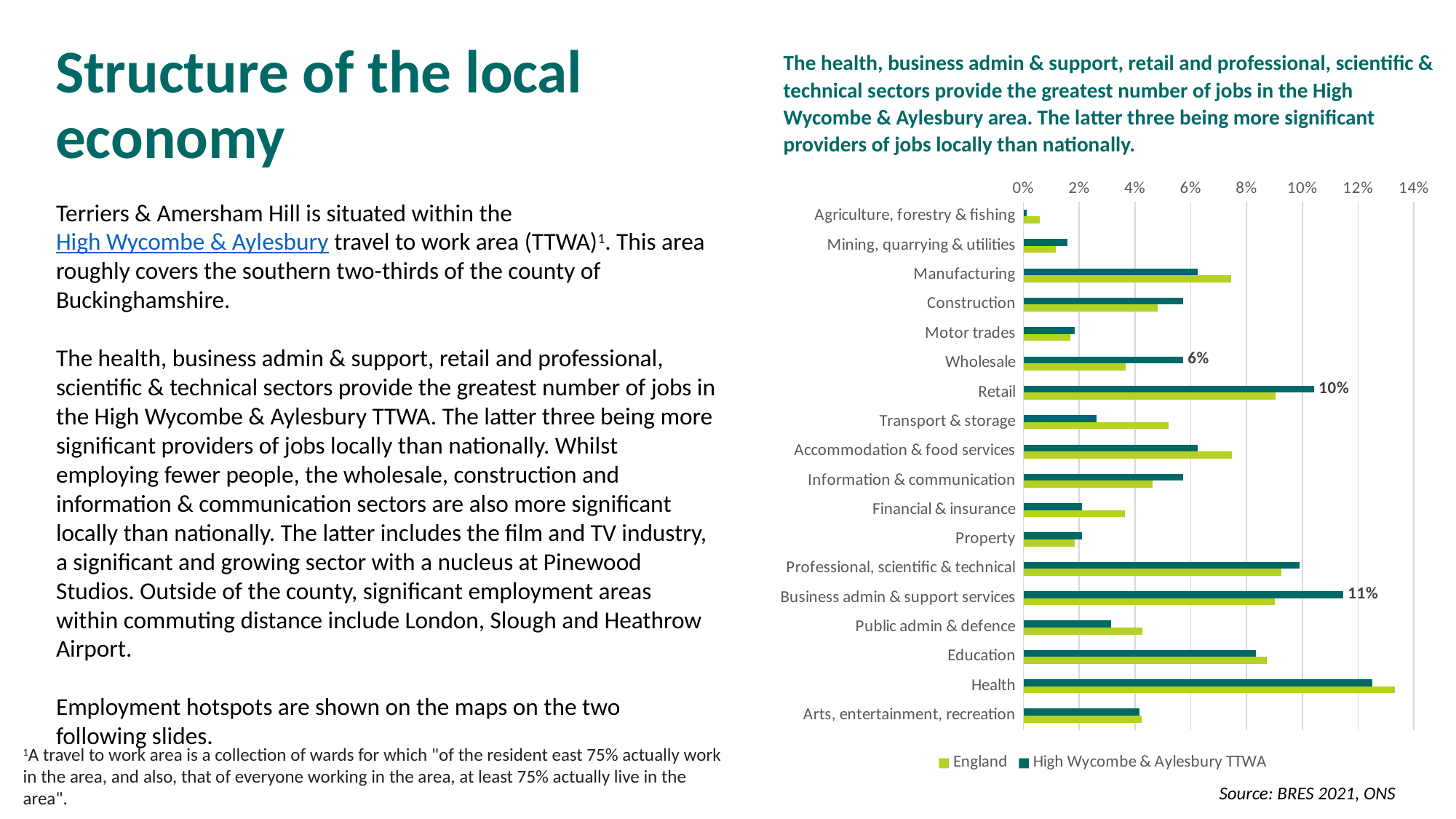
What is the value for Business admin & support services in the High Wycombe & Aylesbury TTWA series? 11% What is the value for Wholesale in the High Wycombe & Aylesbury TTWA series? 6% What is the value for Retail in the High Wycombe & Aylesbury TTWA series? 10% Which sector has the highest value in the England series? Health Which sector has the lowest value in the High Wycombe & Aylesbury TTWA series? Agriculture, forestry & fishing Is the value for Health in the England series greater or less than 12%? greater What is the difference between the High Wycombe & Aylesbury TTWA values for Business admin & support services and Retail? 1% How many series does the legend list? 2 What kind of chart is shown on the slide? Bar chart What source is cited for the chart? BRES 2021, ONS How many sectors are shown on the chart? 18 For Transport & storage, which series has the larger value, England or High Wycombe & Aylesbury TTWA? England